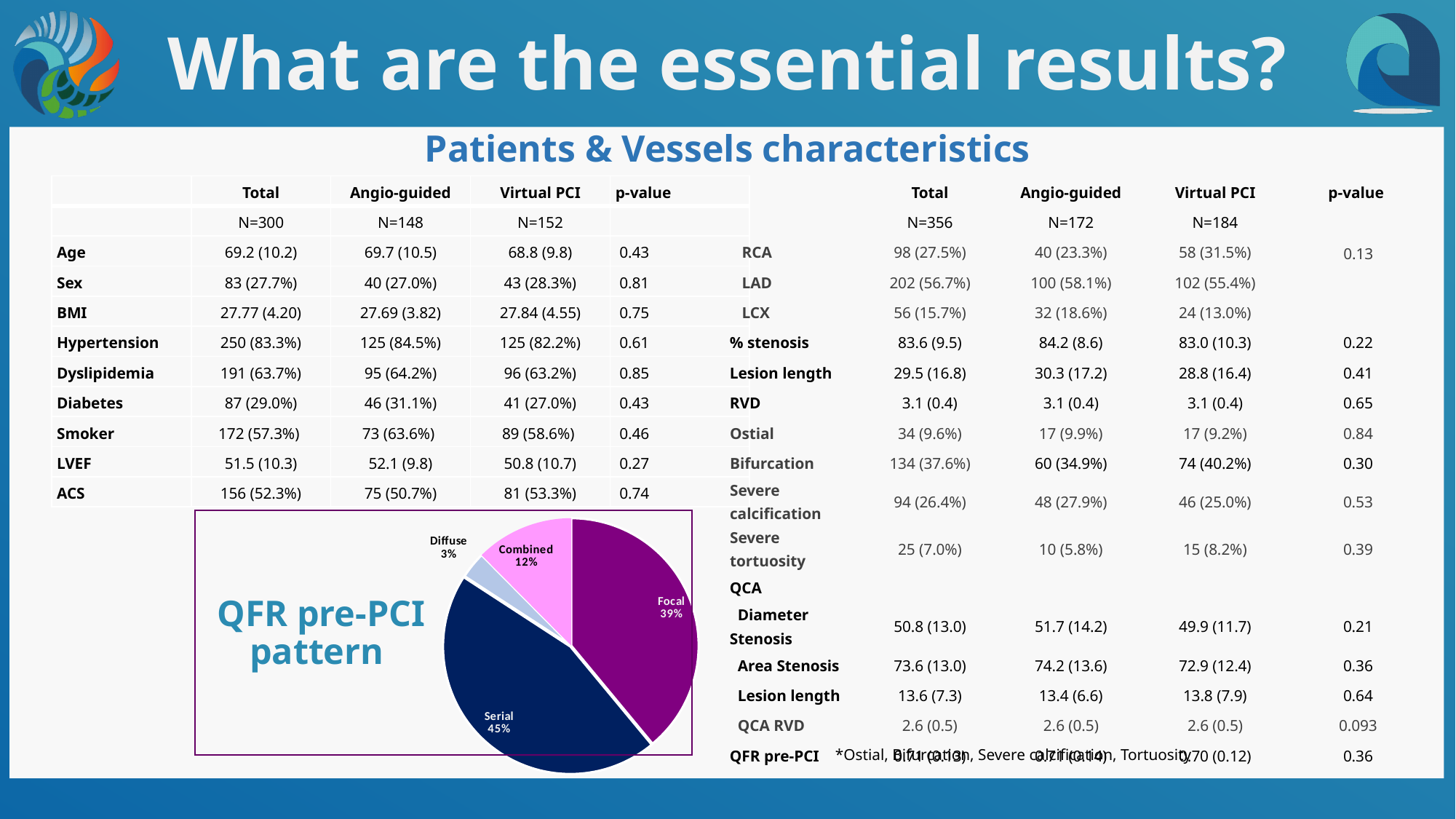
What share of the pie does the Combined slice represent? 12% What colour is the Serial slice in the pie chart? dark navy blue What share of the pie does the Diffuse slice represent? 3% How many slices does the QFR pre-PCI pattern pie chart have? 4 Which slice of the QFR pre-PCI pattern pie chart is the smallest? Diffuse What share of the pie does the Focal slice represent? 39% Which slice of the QFR pre-PCI pattern pie chart is the largest? Serial What kind of chart is shown on the slide? pie chart What is the title of the pie chart? QFR pre-PCI pattern What is the difference in percentage points between the Serial and Focal slices? 6 Which is larger in the pie chart, the Combined slice or the Diffuse slice? Combined